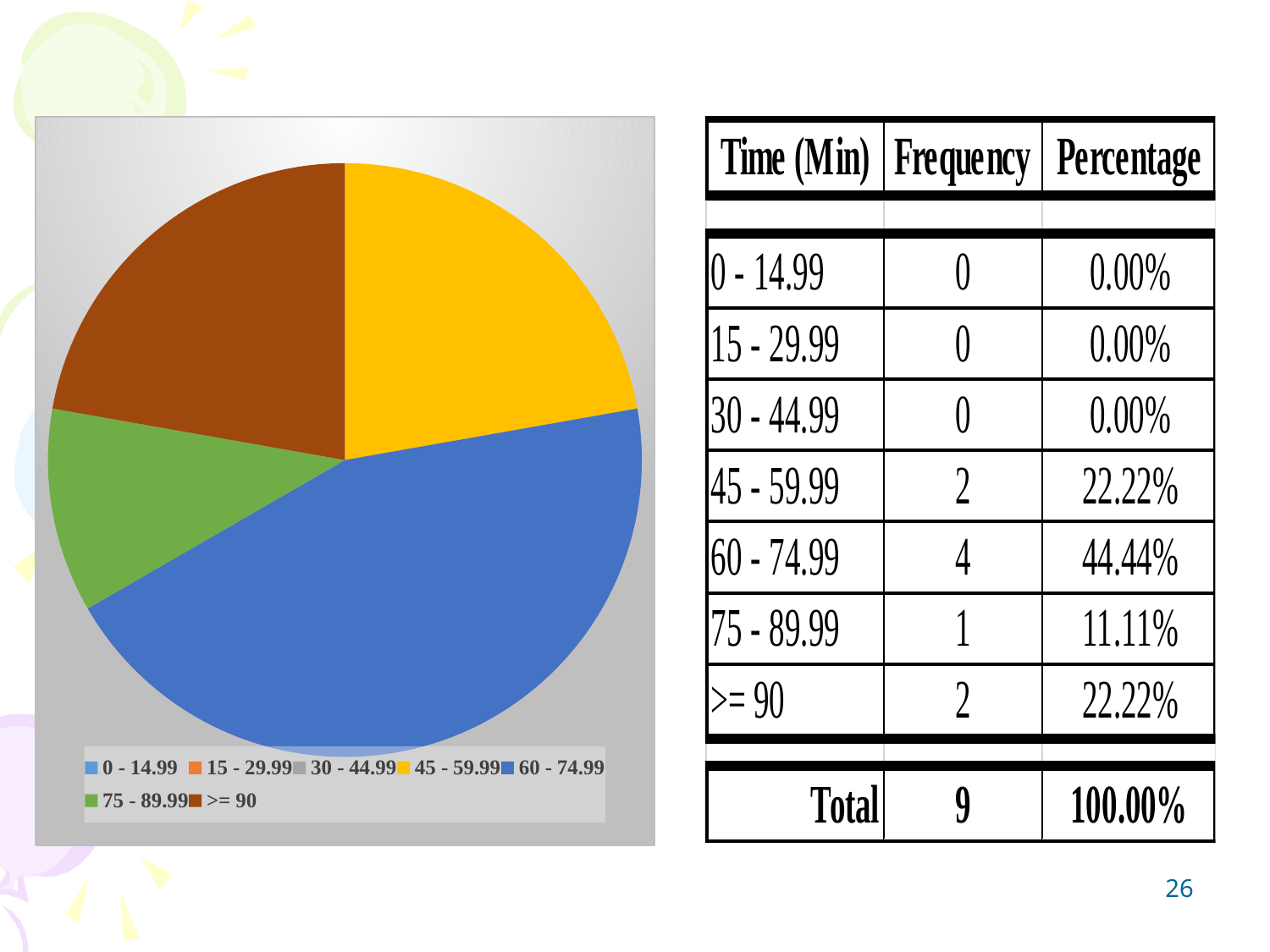
What percentage share does the 60 - 74.99 category have? 44.44% What kind of chart is shown on the slide? pie chart What percentage share does the 75 - 89.99 category have? 11.11% Which time category has the largest slice of the pie chart? 60 - 74.99 What is the difference in frequency between the 60 - 74.99 category and the 75 - 89.99 category? 3 What colour is the slice for the 60 - 74.99 category? blue What is the frequency for the 45 - 59.99 category? 2 How many categories does the pie chart's legend list? 7 Which is larger, the slice for 45 - 59.99 or the slice for 75 - 89.99? 45 - 59.99 What is the frequency for the >= 90 category? 2 Which time category has the smallest visible slice of the pie chart? 75 - 89.99 What is the total frequency across all categories? 9